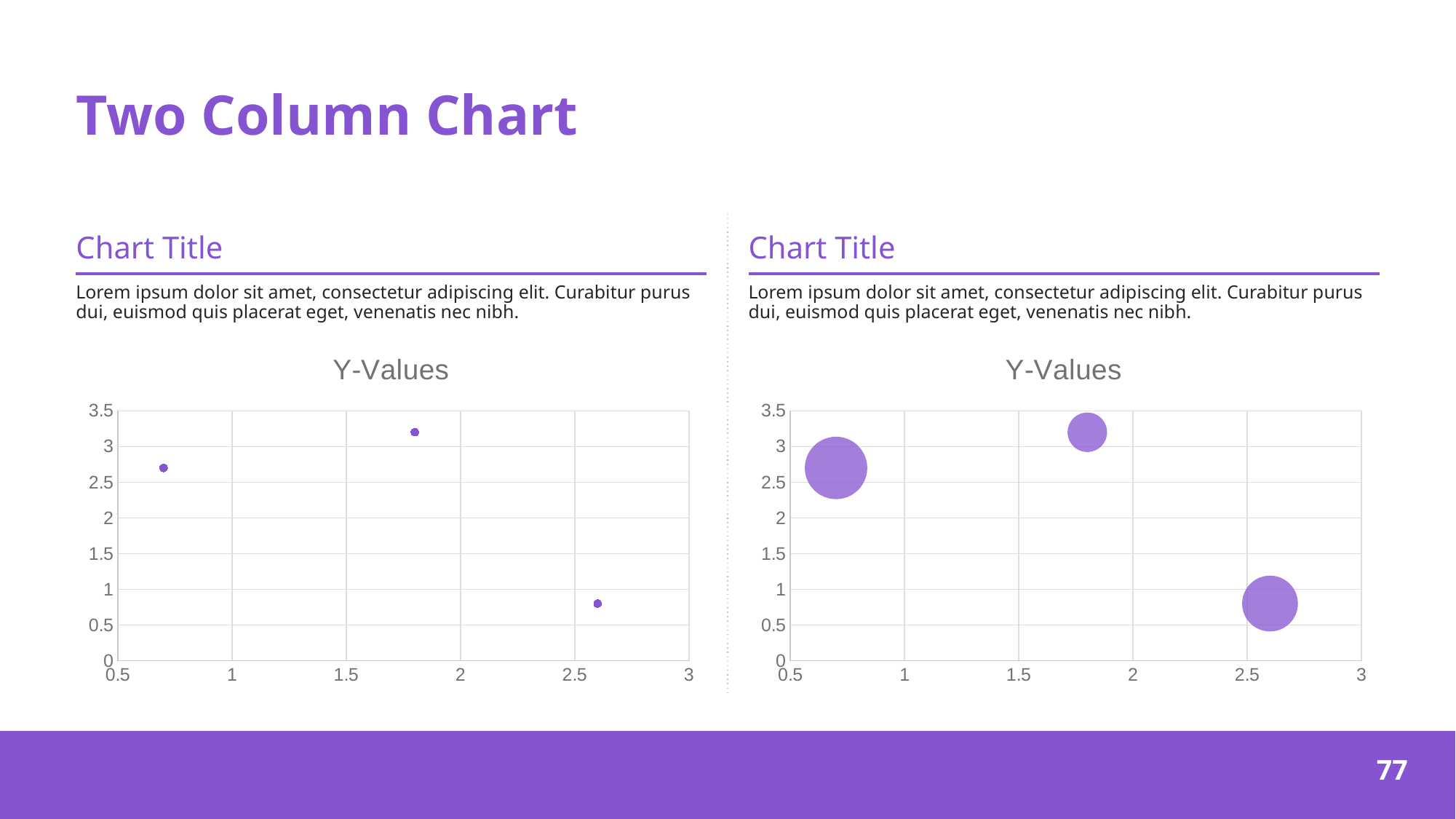
How many bubbles are plotted in the right chart? 3 What is the title shown above the left chart's plot area? Y-Values In the left chart, do the y values rise or fall from the middle point to the rightmost point? fall How many data points are plotted in the left chart? 3 What kind of chart is the right chart on the slide? bubble chart In the left chart, is the highest point located at the left, middle, or right along the x axis? middle What kind of chart is the left chart on the slide? scatter chart In the left chart, is the y value of the rightmost point greater or less than 1? less In the left chart, is the lowest point located at the left, middle, or right along the x axis? right In the right chart, which bubble is the largest: the leftmost, middle, or rightmost? leftmost In the left chart, is the y value of the leftmost point greater or less than 2.5? greater In the right chart, is the y value of the middle bubble greater or less than 3? greater